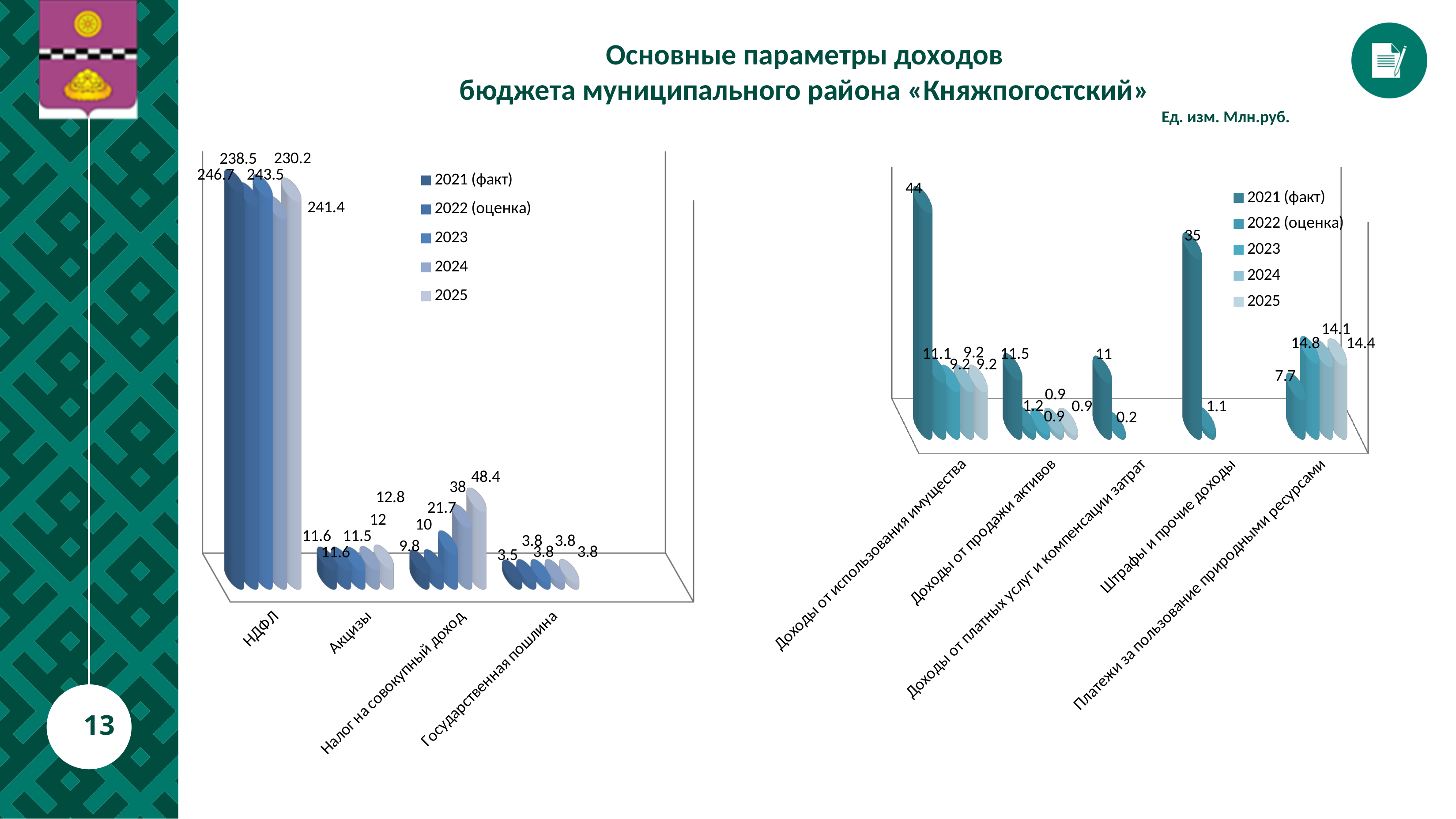
On the right chart, what is the 2021 (факт) value for Доходы от использования имущества? 44 On the left chart, what is the 2021 (факт) value for НДФЛ? 246.7 What type of chart is the right chart? bar chart On the left chart, what is the difference between the 2025 and 2021 (факт) values for Налог на совокупный доход? 38.6 On the left chart, which category has the highest values across all years? НДФЛ How many categories are shown on the right chart? 5 On the left chart, which category has the lowest values across all years? Государственная пошлина How many series does the legend of the left chart list? 5 On the left chart, what is the 2024 value for НДФЛ? 230.2 On the left chart, do the values for Налог на совокупный доход rise or fall from 2021 to 2025? rise On the left chart, what is the 2025 value for Налог на совокупный доход? 48.4 On the right chart, which is larger: the 2021 (факт) value for Штрафы и прочие доходы or the 2021 (факт) value for Доходы от продажи активов? Штрафы и прочие доходы